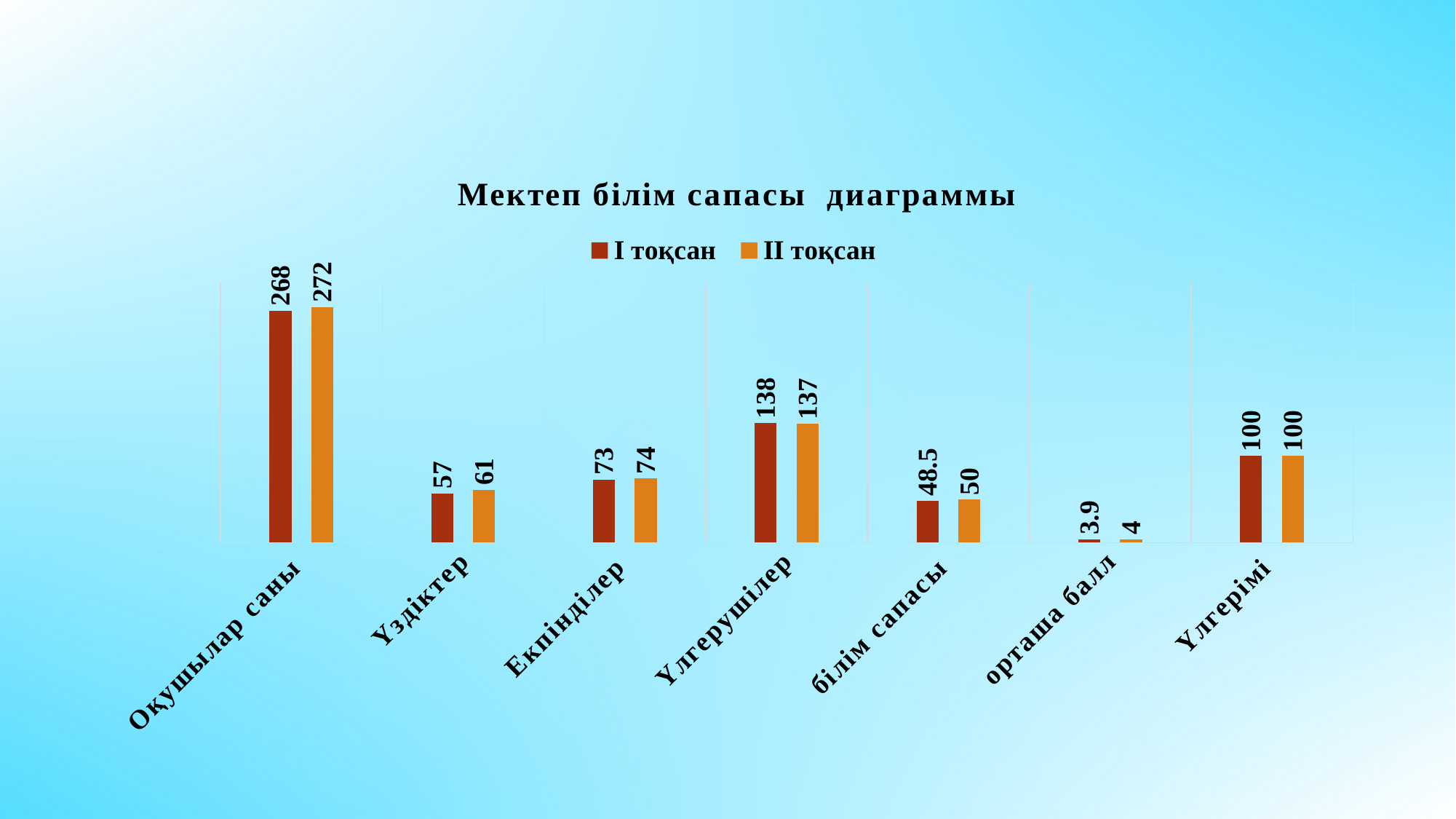
Which is larger for Екпінділер: the I тоқсан value or the II тоқсан value? II тоқсан What is the value for орташа балл in the II тоқсан series? 4 What is the difference between the II тоқсан and I тоқсан values for Оқушылар саны? 4 What kind of chart is shown on the slide? Bar chart What is the difference between the I тоқсан and II тоқсан values for Үлгерушілер? 1 Which category has the lowest value in the I тоқсан series? орташа балл What is the value for Үздіктер in the II тоқсан series? 61 Which category has the highest value in the II тоқсан series? Оқушылар саны What is the value for Оқушылар саны in the I тоқсан series? 268 What is the value for білім сапасы in the I тоқсан series? 48.5 How many series does the legend list? 2 How many categories are shown on the x axis? 7